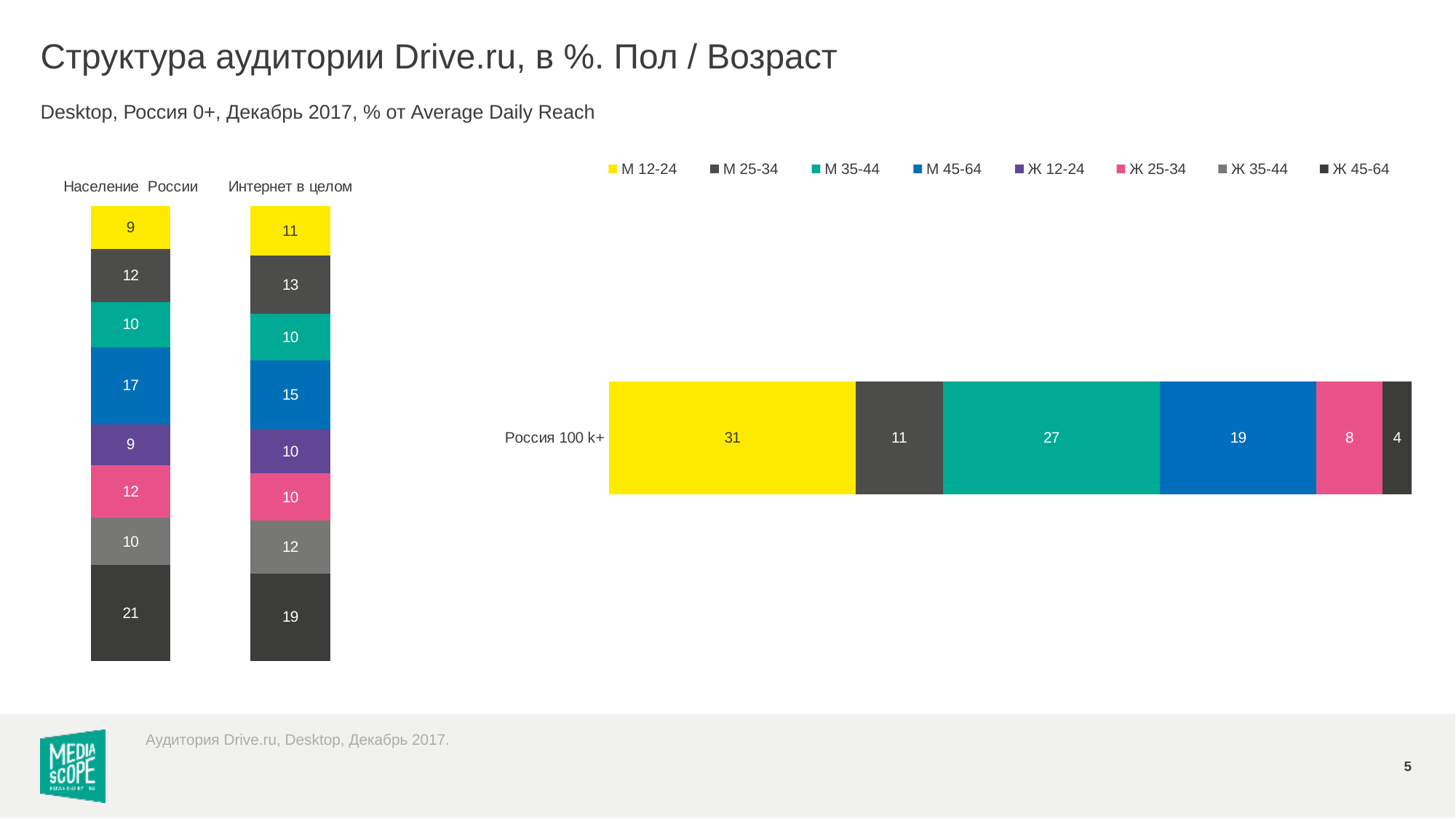
In the 'Россия 100 k+' bar, which segment is the largest? М 12-24 In the 'Россия 100 k+' bar, what is the difference between the М 12-24 value and the М 45-64 value? 12 In the 'Население России' bar, what is the value for М 45-64? 17 What kind of chart is shown for 'Россия 100 k+'? Stacked bar chart In the 'Интернет в целом' bar, what is the value for М 25-34? 13 In the 'Население России' bar, which segment is the largest? Ж 45-64 What is the total of the 'Россия 100 k+' stacked bar? 100 In the 'Россия 100 k+' bar, what is the value for М 35-44? 27 In the 'Население России' bar, what is the value for Ж 45-64? 21 Which is larger: the М 12-24 value in 'Население России' or in 'Интернет в целом'? Интернет в целом How many series does the legend list? 8 In the 'Россия 100 k+' bar, what is the value for М 12-24? 31